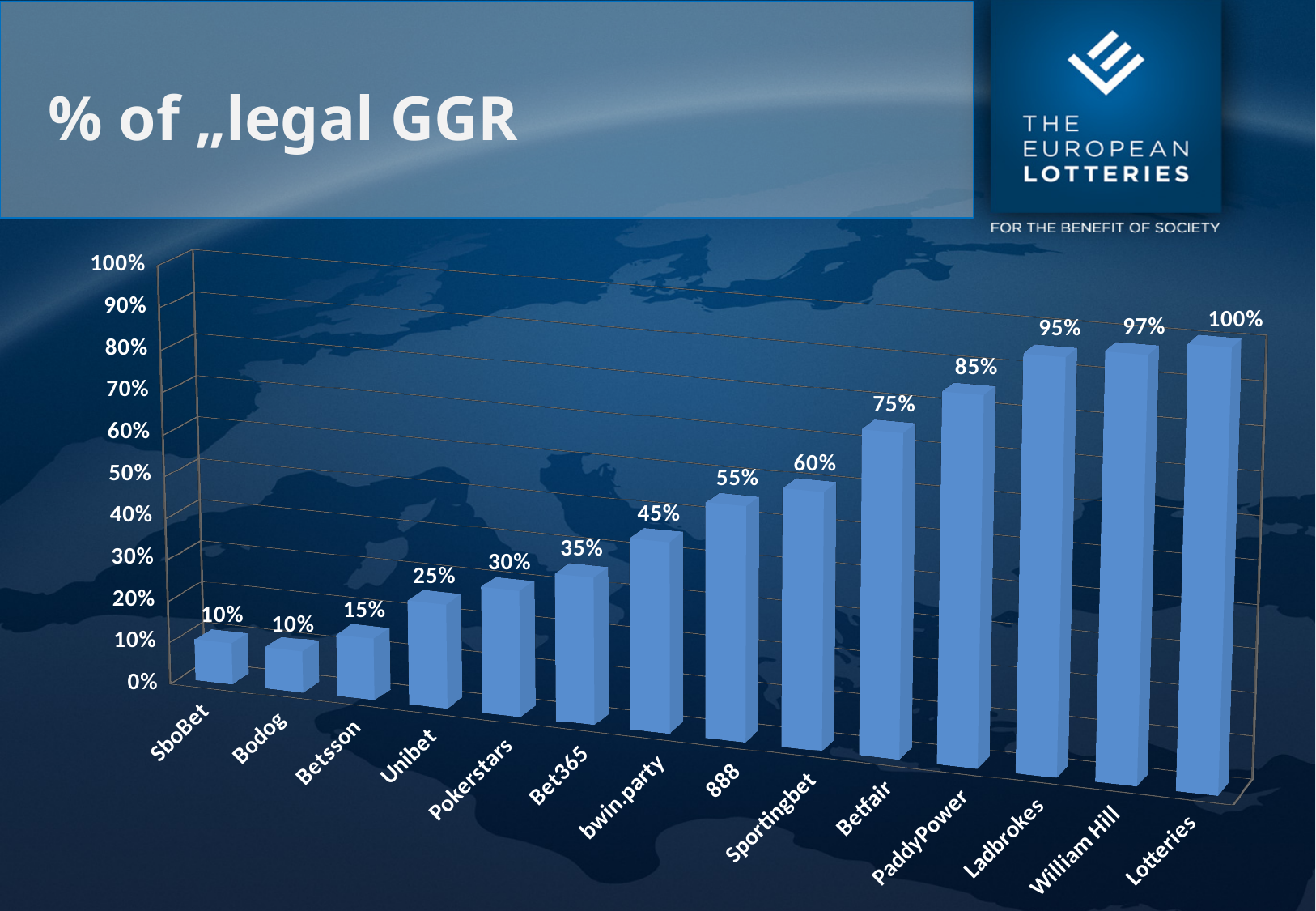
What is the value for Betfair? 75% Which category has the highest value? Lotteries What is the value for Unibet? 25% Is the value for PaddyPower greater or less than 80%? greater What is the difference between the values for Ladbrokes and Sportingbet? 35% What kind of chart is shown on the slide? bar chart Do the values rise or fall from left to right along the x axis? rise What is the difference between the values for Pokerstars and Bodog? 20% How many categories are shown on the chart? 14 What is the value for William Hill? 97% What is the title of the chart? % of „legal GGR Which is larger, the value for 888 or the value for bwin.party? 888